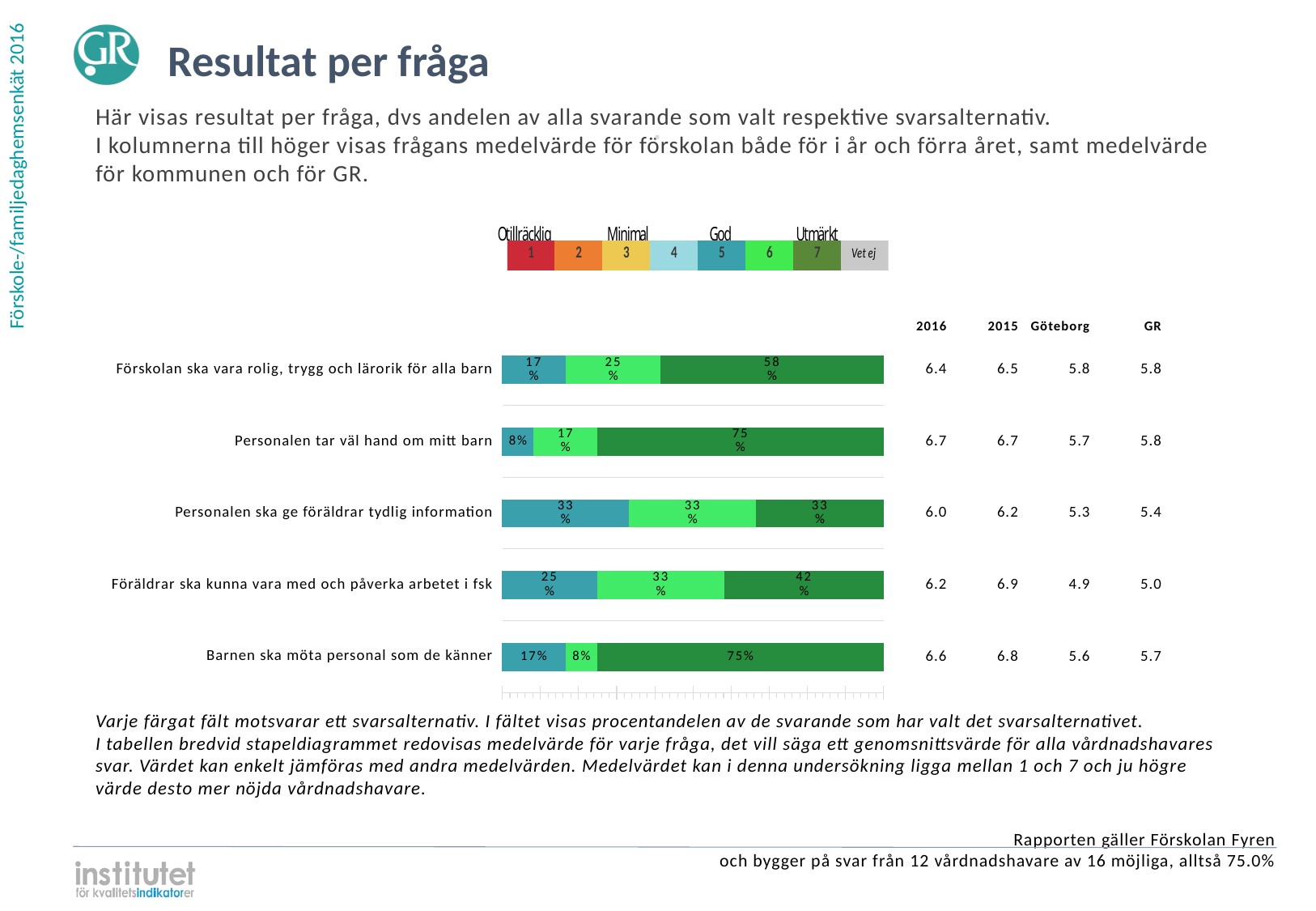
What is the total of the three labelled segments for 'Förskolan ska vara rolig, trygg och lärorik för alla barn'? 100% How many questions (categories) are shown in the bar chart? 5 What percentage of respondents chose the highest option (7, dark green) for 'Personalen tar väl hand om mitt barn'? 75% What is the 2016 mean value for 'Personalen ska ge föräldrar tydlig information'? 6.0 What kind of chart is used to show the results per question? Stacked bar chart Which is larger: the light green (6) segment for 'Förskolan ska vara rolig, trygg och lärorik för alla barn' or for 'Barnen ska möta personal som de känner'? Förskolan ska vara rolig, trygg och lärorik för alla barn How many response options does the legend above the chart list, including 'Vet ej'? 8 What percentage is shown for the teal (5) segment of 'Föräldrar ska kunna vara med och påverka arbetet i fsk'? 25% Which question has the smallest dark green (7) segment? Personalen ska ge föräldrar tydlig information What is the difference between the dark green (7) segment for 'Barnen ska möta personal som de känner' and for 'Förskolan ska vara rolig, trygg och lärorik för alla barn'? 17 percentage points Which question has the highest 2016 mean value in the table? Personalen tar väl hand om mitt barn What is the Göteborg mean value for 'Föräldrar ska kunna vara med och påverka arbetet i fsk'? 4.9